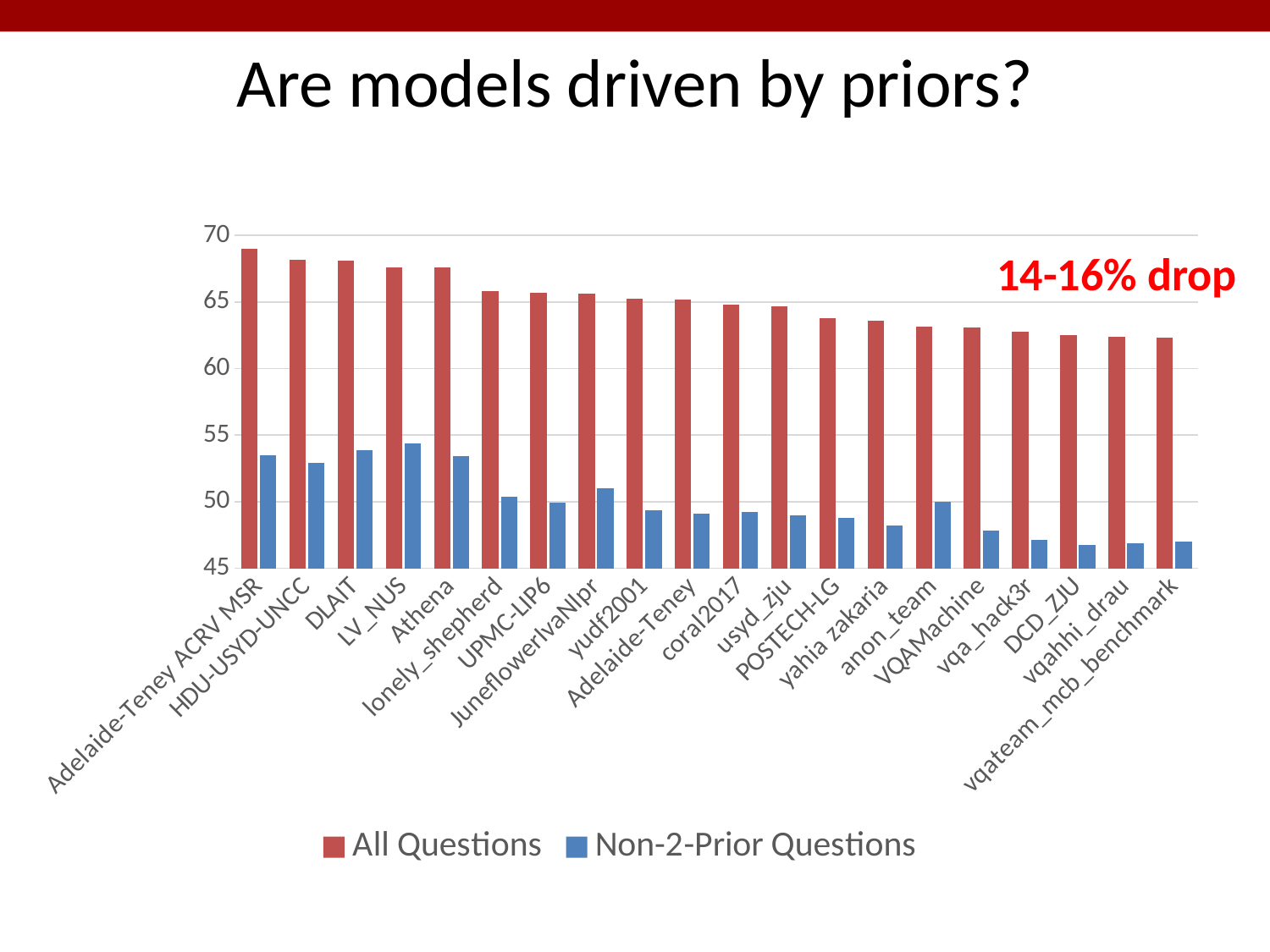
Which team has the highest All Questions value? Adelaide-Teney ACRV MSR For DLAIT, which is larger: the All Questions value or the Non-2-Prior Questions value? All Questions Is the All Questions value for anon_team greater or less than 65? less Is the All Questions value for vqateam_mcb_benchmark greater or less than 60? greater What kind of chart is shown on the slide? bar chart Do the All Questions values rise or fall moving left to right along the x axis? fall Is the Non-2-Prior Questions value for Adelaide-Teney ACRV MSR greater or less than 55? less How many series does the legend list? 2 What drop does the red annotation on the chart state? 14-16% drop How many teams (categories) are plotted along the x axis? 20